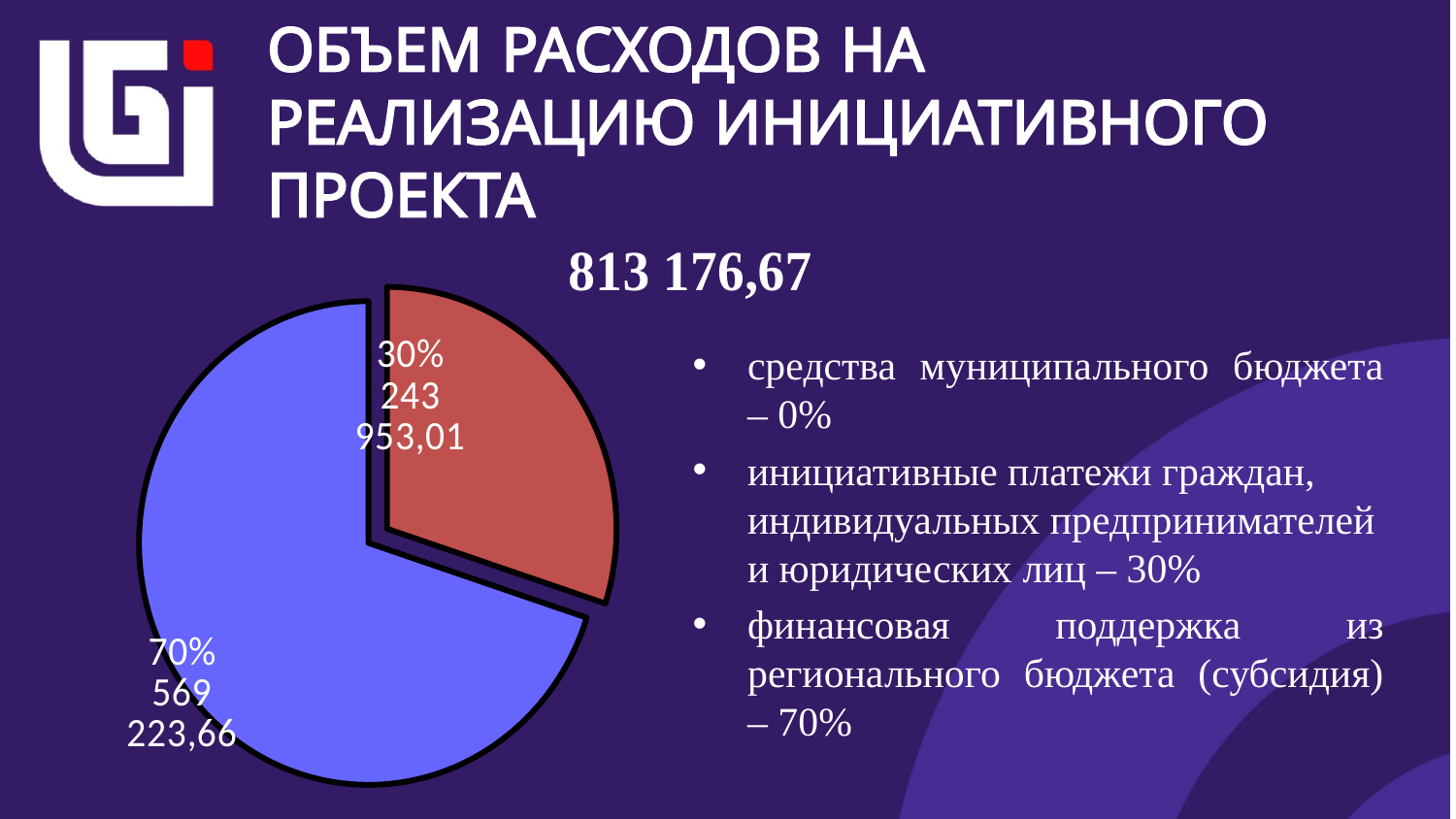
Which is larger, the value of the blue slice or the value of the red slice? the blue slice How many slices does the pie chart have? 2 What value is printed on the 70% slice of the pie chart? 569 223,66 What is the total of the two values shown on the pie chart? 813 176,67 What share of the pie does the blue slice represent? 70% What value is printed on the 30% slice of the pie chart? 243 953,01 Which slice of the pie chart is the smallest? the red 30% slice What share of the pie does the red slice represent? 30% What is the difference between the value of the 70% slice and the value of the 30% slice? 325 270,65 What type of chart is shown on the slide? pie chart What colour is the slice labelled 70%? blue Which slice of the pie chart is the largest? the blue 70% slice